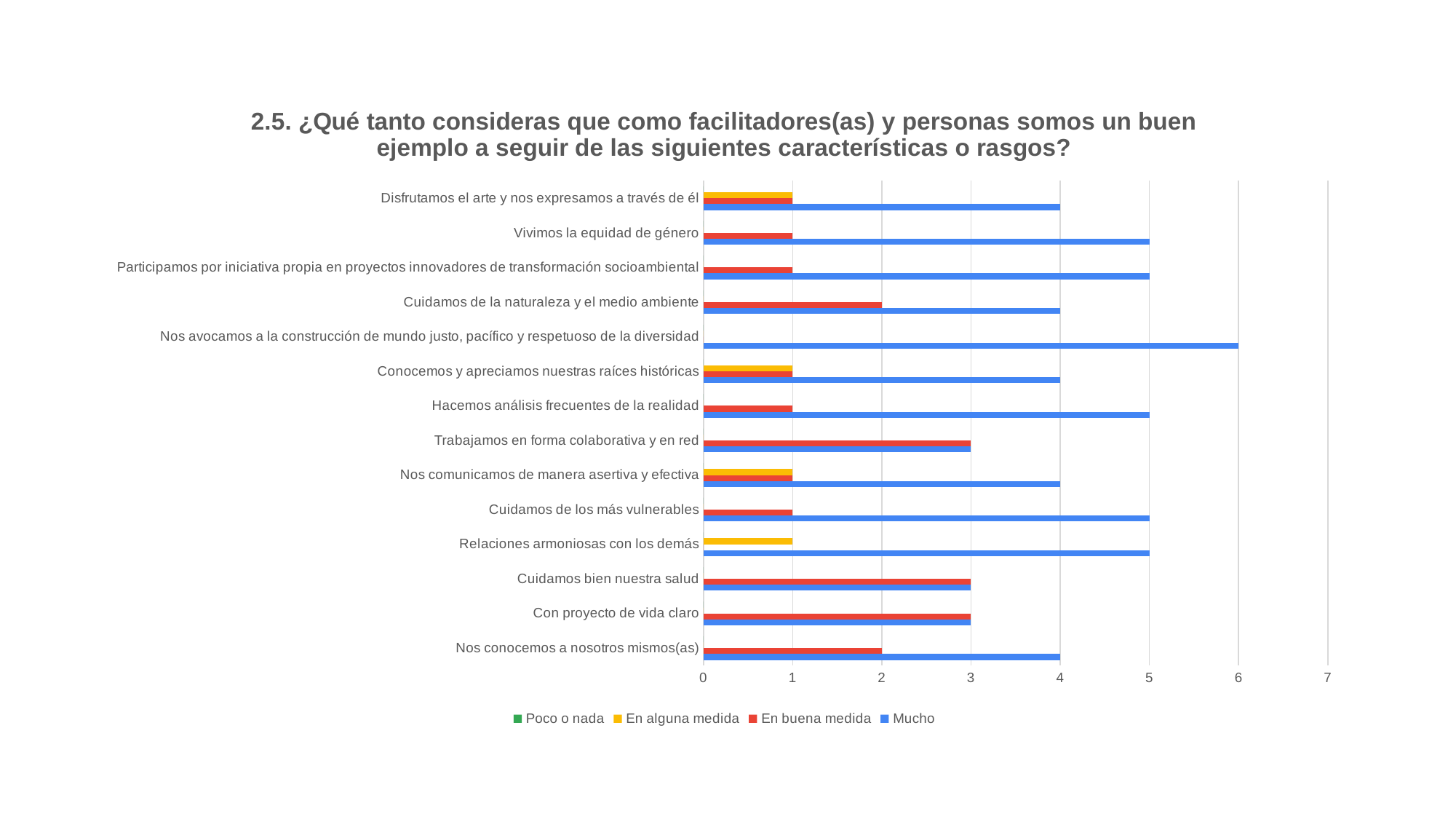
What is the 'Mucho' value for 'Nos avocamos a la construcción de mundo justo, pacífico y respetuoso de la diversidad'? 6 Which is larger: the 'Mucho' value for 'Cuidamos de los más vulnerables' or the 'Mucho' value for 'Cuidamos bien nuestra salud'? Cuidamos de los más vulnerables Which category has the highest value for the 'Mucho' series? Nos avocamos a la construcción de mundo justo, pacífico y respetuoso de la diversidad Is the 'Mucho' value for 'Con proyecto de vida claro' greater or less than 4? less What is the 'Mucho' value for 'Vivimos la equidad de género'? 5 What is the 'En buena medida' value for 'Trabajamos en forma colaborativa y en red'? 3 What kind of chart is shown on the slide? bar chart Which series is shown in yellow in the legend? En alguna medida What is the 'En buena medida' value for 'Cuidamos de la naturaleza y el medio ambiente'? 2 How many categories (characteristics) are listed on the vertical axis of the chart? 14 What is the difference between the 'Mucho' value and the 'En buena medida' value for 'Nos conocemos a nosotros mismos(as)'? 2 How many series does the legend list? 4